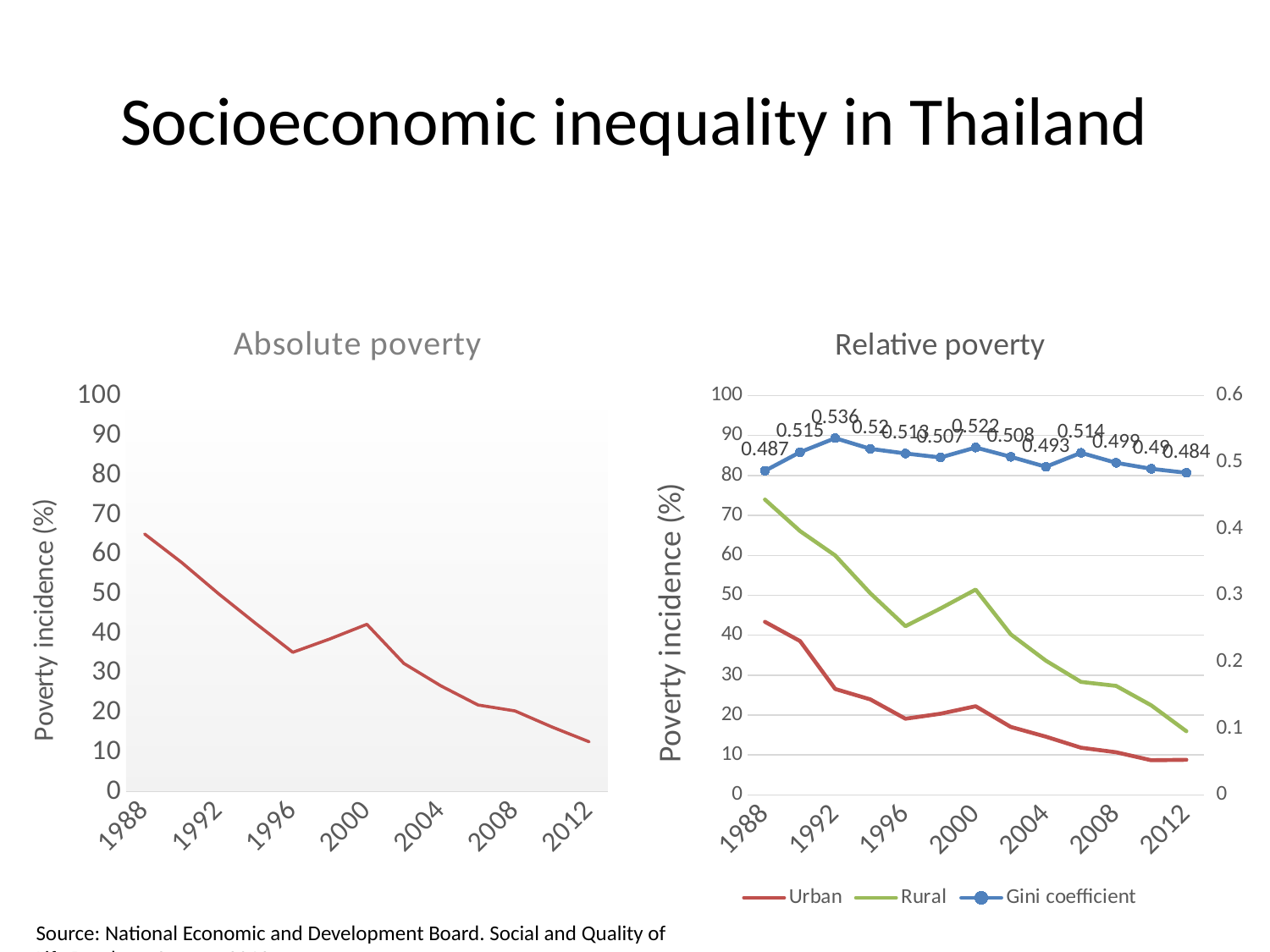
In the 'Absolute poverty' chart, does poverty incidence overall rise or fall from 1988 to 2012? fall What kind of chart is the 'Absolute poverty' chart? line chart In the 'Relative poverty' chart, how many data labels are shown on the Gini coefficient line? 13 In the 'Relative poverty' chart, what is the difference between the highest and lowest labelled Gini coefficient values? 0.052 In the 'Relative poverty' chart, which series has the higher poverty incidence in 1988, Urban or Rural? Rural How many series does the legend of the 'Relative poverty' chart list? 3 In the 'Relative poverty' chart, what is the Gini coefficient value labelled at 1988? 0.487 In the 'Relative poverty' chart, what is the highest labelled Gini coefficient value? 0.536 In the 'Absolute poverty' chart, is the value for 1988 greater or less than 60? greater In the 'Relative poverty' chart, what is the lowest labelled Gini coefficient value? 0.484 In the 'Relative poverty' chart, what is the Gini coefficient value labelled at 2012? 0.484 In the 'Absolute poverty' chart, is the value for 2012 greater or less than 20? less